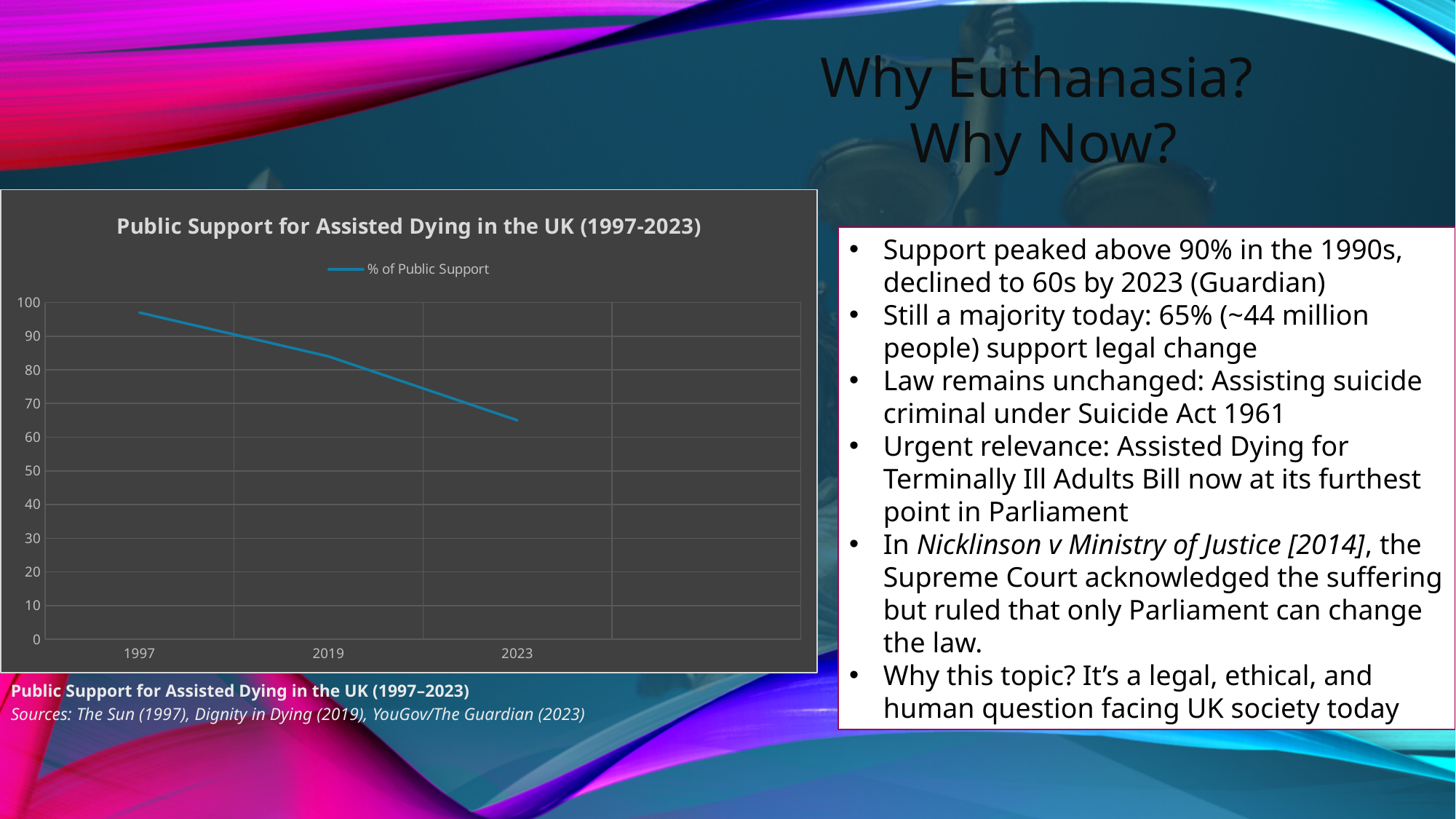
Do the values rise or fall from 1997 to 2023? Fall Is the value for 2019 greater or less than 90? less What kind of chart is shown on the slide? Line chart Is the value for 2023 greater or less than 70? less How many series does the legend list? 1 Is the value for 1997 greater or less than 90? greater What is the title of the chart? Public Support for Assisted Dying in the UK (1997-2023) Which is larger, the value for 2019 or the value for 2023? 2019 Which year has the lowest value for % of Public Support? 2023 What series name does the chart legend show? % of Public Support Which year has the highest value for % of Public Support? 1997 How many years are plotted on the x axis? 3